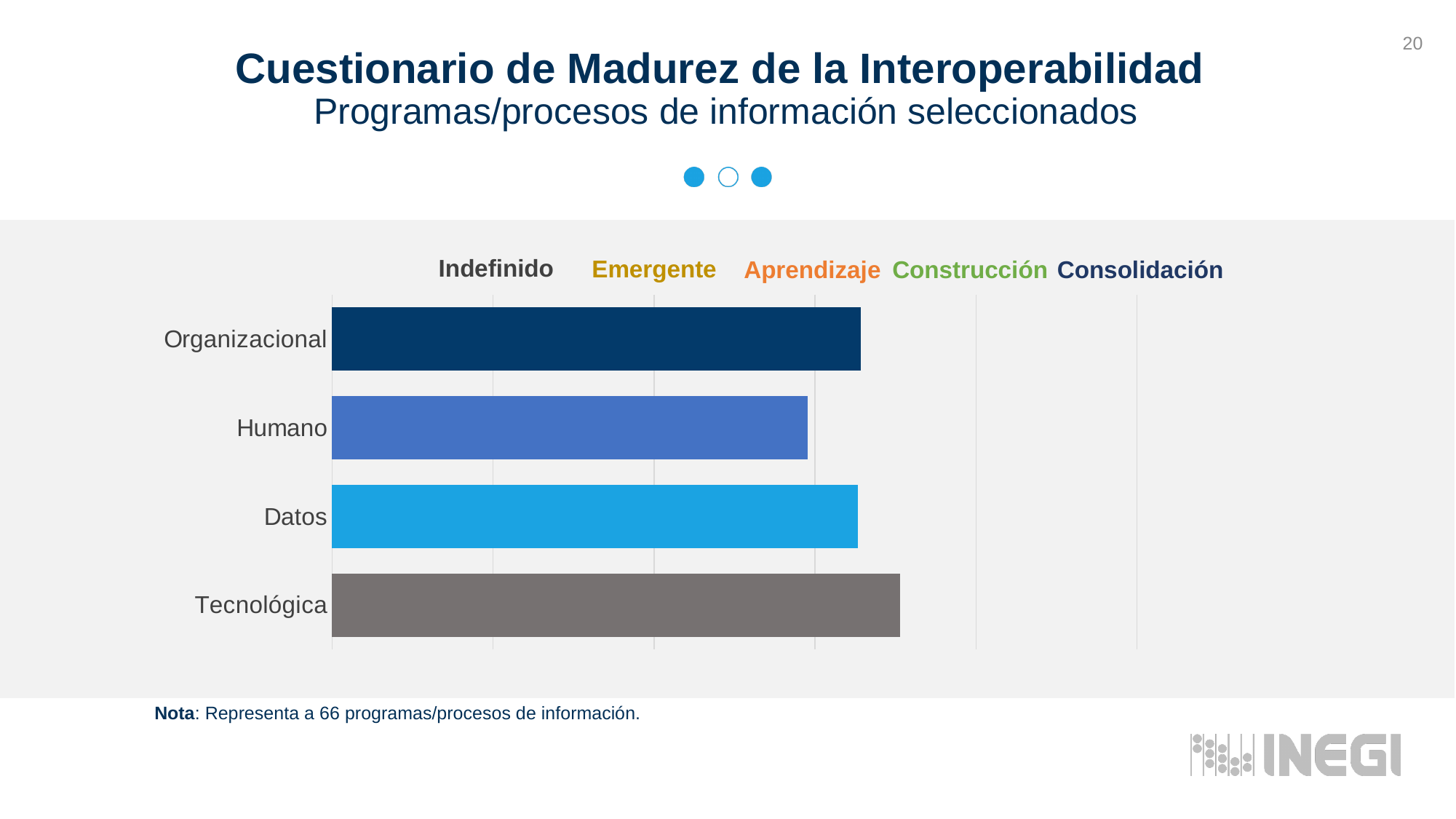
Which category has the shortest bar? Humano Which bar is longer, Tecnológica or Humano? Tecnológica Which category has the longest bar? Tecnológica What is the main title of the slide containing the chart? Cuestionario de Madurez de la Interoperabilidad Which bar is longer, Organizacional or Humano? Organizacional Which bar is longer, Datos or Humano? Datos How many categories (bars) does the chart show? 4 What kind of chart is shown on the slide? bar chart How many maturity level labels are shown along the top of the chart? 5